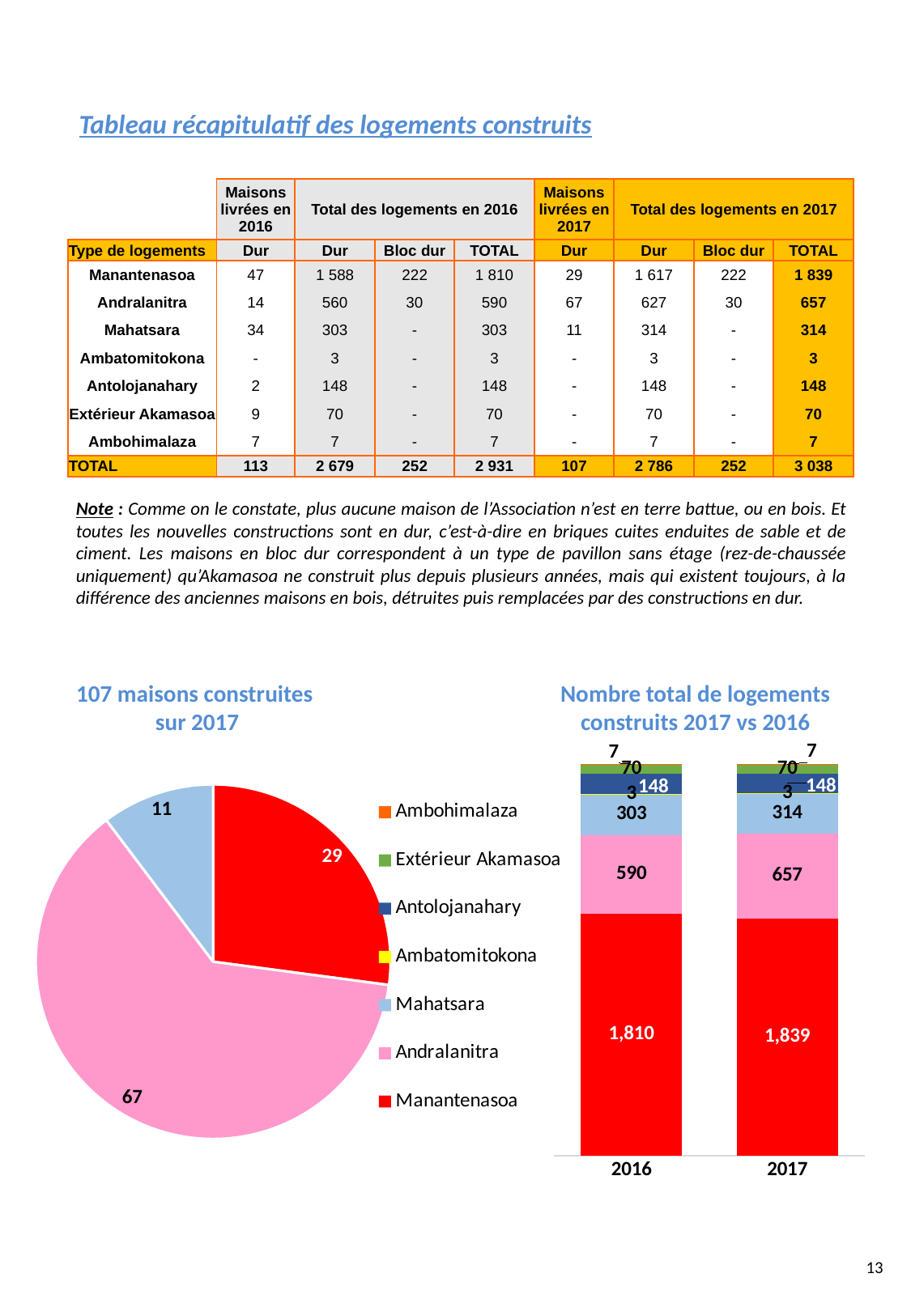
In the pie chart '107 maisons construites sur 2017', what is the difference between the Andralanitra and Manantenasoa values? 38 In the chart 'Nombre total de logements construits 2017 vs 2016', what is the difference between the Andralanitra values for 2017 and 2016? 67 In the chart 'Nombre total de logements construits 2017 vs 2016', which is larger: the Mahatsara value for 2016 or for 2017? 2017 In the chart 'Nombre total de logements construits 2017 vs 2016', what is the Andralanitra value for 2016? 590 In the chart 'Nombre total de logements construits 2017 vs 2016', how many bars are plotted? 2 In the pie chart '107 maisons construites sur 2017', what value is shown for the Manantenasoa slice? 29 In the chart 'Nombre total de logements construits 2017 vs 2016', what is the Manantenasoa value for 2017? 1,839 In the chart 'Nombre total de logements construits 2017 vs 2016', what is the total of the 2016 stacked bar? 2,931 In the pie chart '107 maisons construites sur 2017', which category has the largest slice? Andralanitra In the pie chart '107 maisons construites sur 2017', what value is shown for Mahatsara? 11 What kind of chart is 'Nombre total de logements construits 2017 vs 2016'? Stacked bar chart